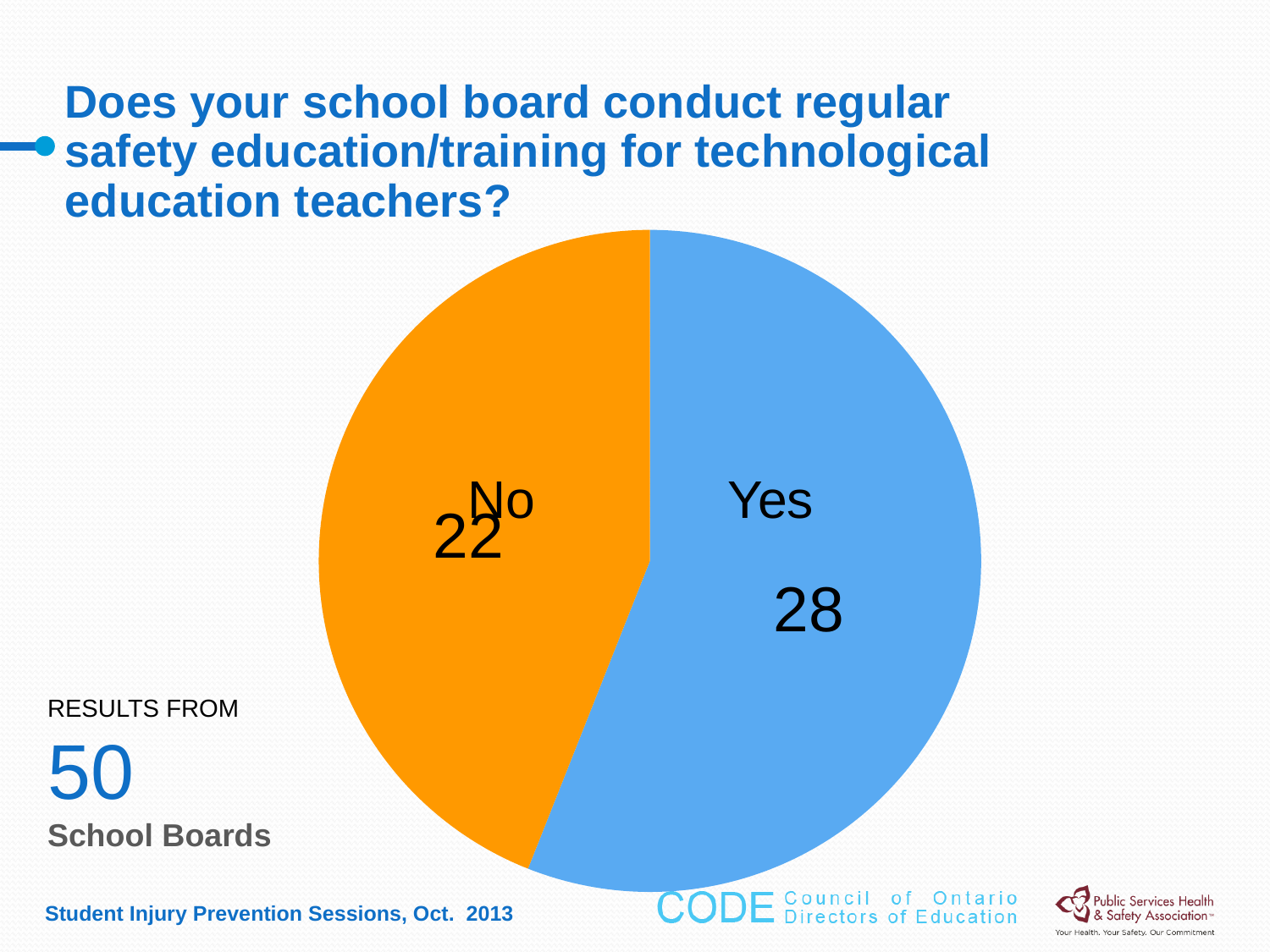
How many school boards answered "Yes"? 28 What colour is the "No" slice of the pie chart? orange What share of the pie does the "Yes" slice represent? 56% Which response has the smaller slice of the pie? No How many slices does the pie chart have? 2 What kind of chart is shown on the slide? pie chart How many school boards answered "No"? 22 What colour is the "Yes" slice of the pie chart? blue Is the value for "Yes" larger or smaller than the value for "No"? larger What is the difference between the number of "Yes" and "No" responses? 6 What is the total of the two slices in the pie chart? 50 Which response has the larger slice of the pie? Yes